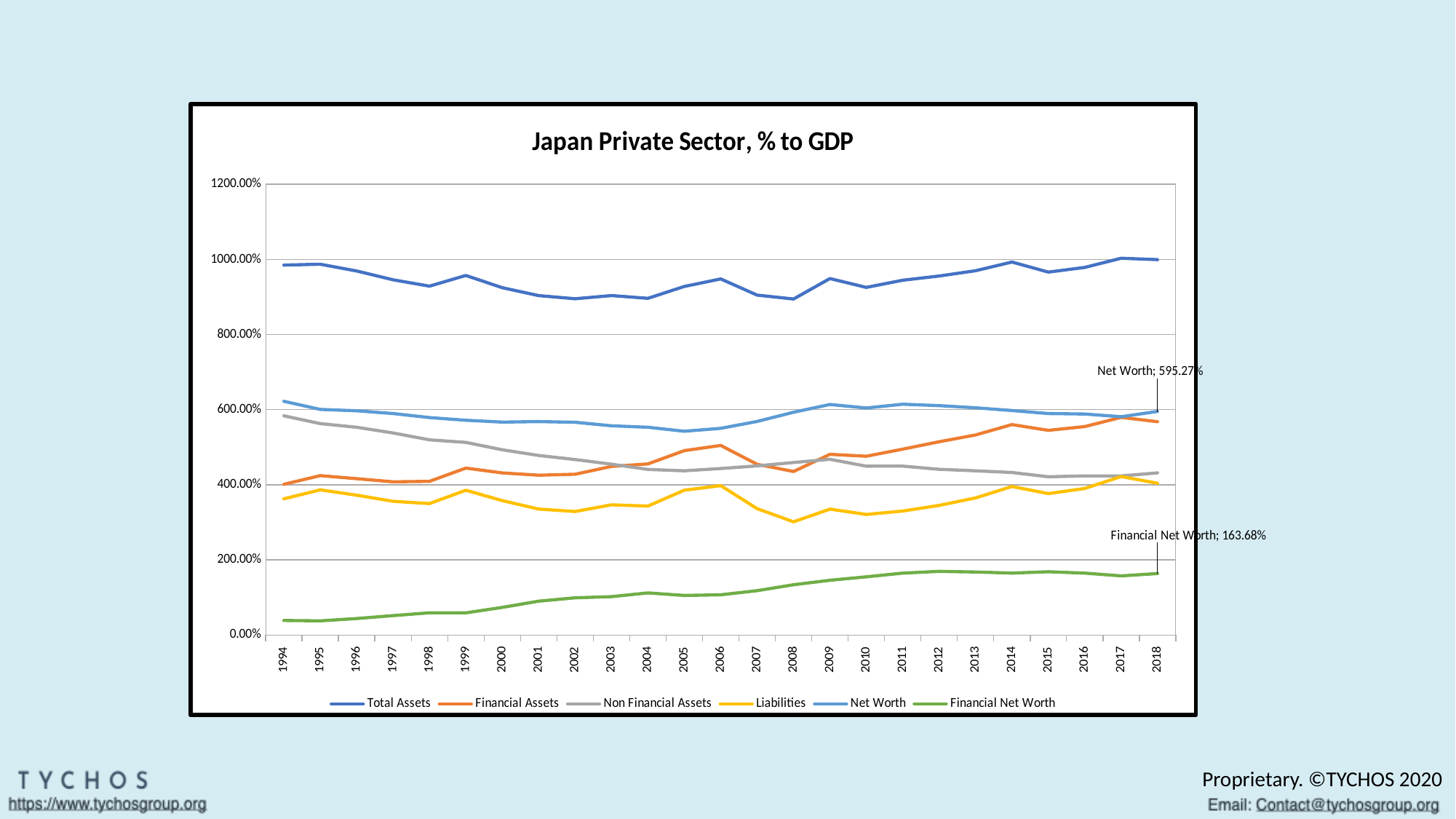
Does the Financial Net Worth series rise or fall from 1994 to 2018? rise What is the difference between Net Worth and Financial Net Worth in 2018? 431.59% What is the Net Worth value for 2018? 595.27% What kind of chart is shown on the slide? line chart What is the Financial Net Worth value for 2018? 163.68% In 1994, which is larger: Financial Assets or Non Financial Assets? Non Financial Assets Is the value for Total Assets in 1994 greater or less than 800.00%? greater How many series does the legend list? 6 Is the value for Liabilities in 2008 greater or less than 400.00%? less Which series has the lowest values across all years? Financial Net Worth How many years are plotted along the x axis? 25 Which series has the highest values across all years? Total Assets